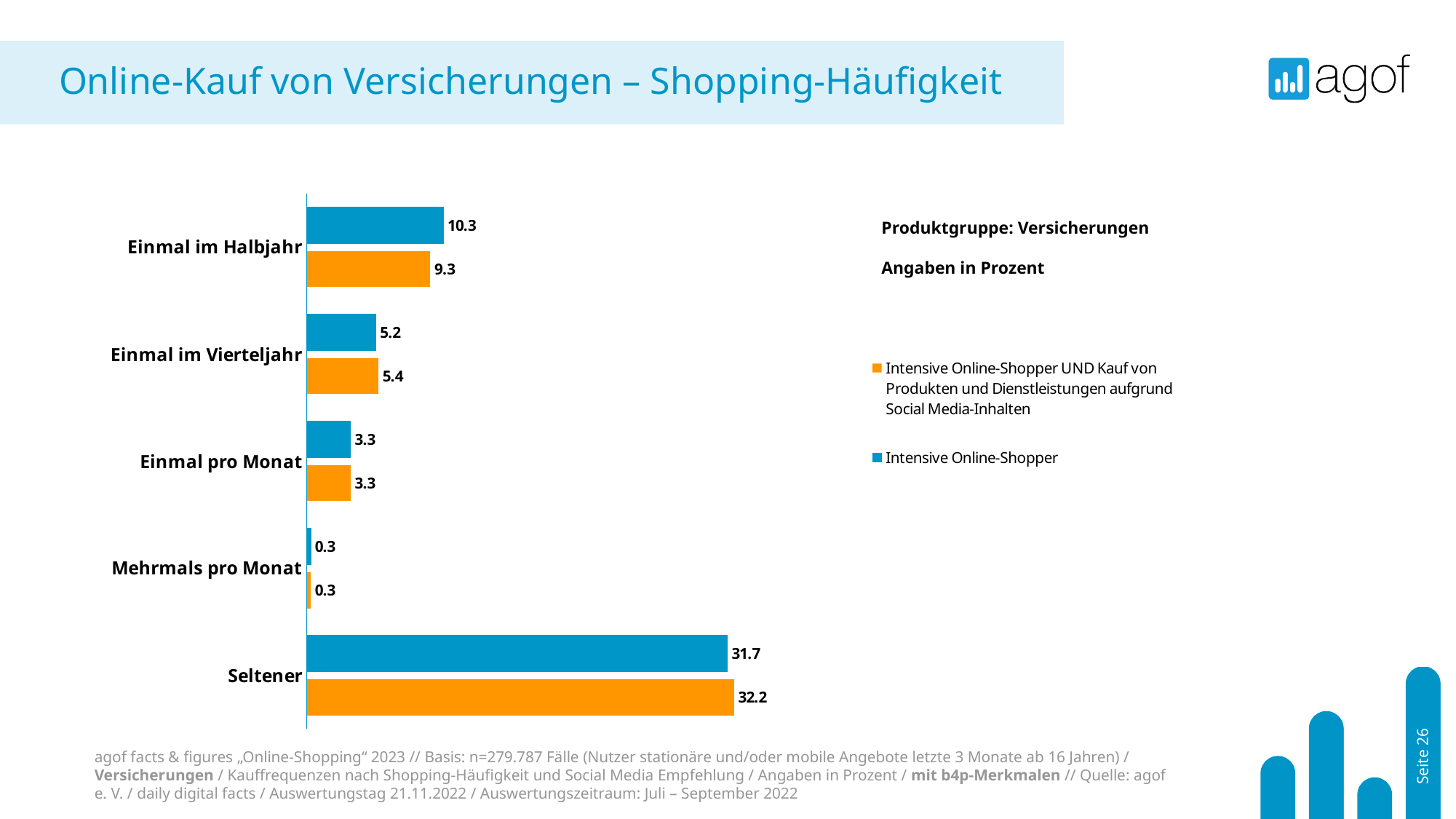
Which category has the lowest value for "Intensive Online-Shopper UND Kauf von Produkten und Dienstleistungen aufgrund Social Media-Inhalten"? Mehrmals pro Monat What is the value for "Intensive Online-Shopper" in the "Einmal im Halbjahr" category? 10.3 Which colour represents the "Intensive Online-Shopper" series? Blue In the "Einmal im Vierteljahr" category, which series has the larger value? Intensive Online-Shopper UND Kauf von Produkten und Dienstleistungen aufgrund Social Media-Inhalten How many series does the legend list? 2 What is the difference between the "Seltener" and "Einmal im Halbjahr" values for "Intensive Online-Shopper"? 21.4 How many categories are shown on the chart? 5 What is the difference between the two series' values in the "Einmal im Halbjahr" category? 1.0 What is the value for "Intensive Online-Shopper UND Kauf von Produkten und Dienstleistungen aufgrund Social Media-Inhalten" in the "Seltener" category? 32.2 What is the value for "Intensive Online-Shopper" in the "Einmal im Vierteljahr" category? 5.2 What kind of chart is shown on the slide? Bar chart Which category has the highest value for "Intensive Online-Shopper"? Seltener